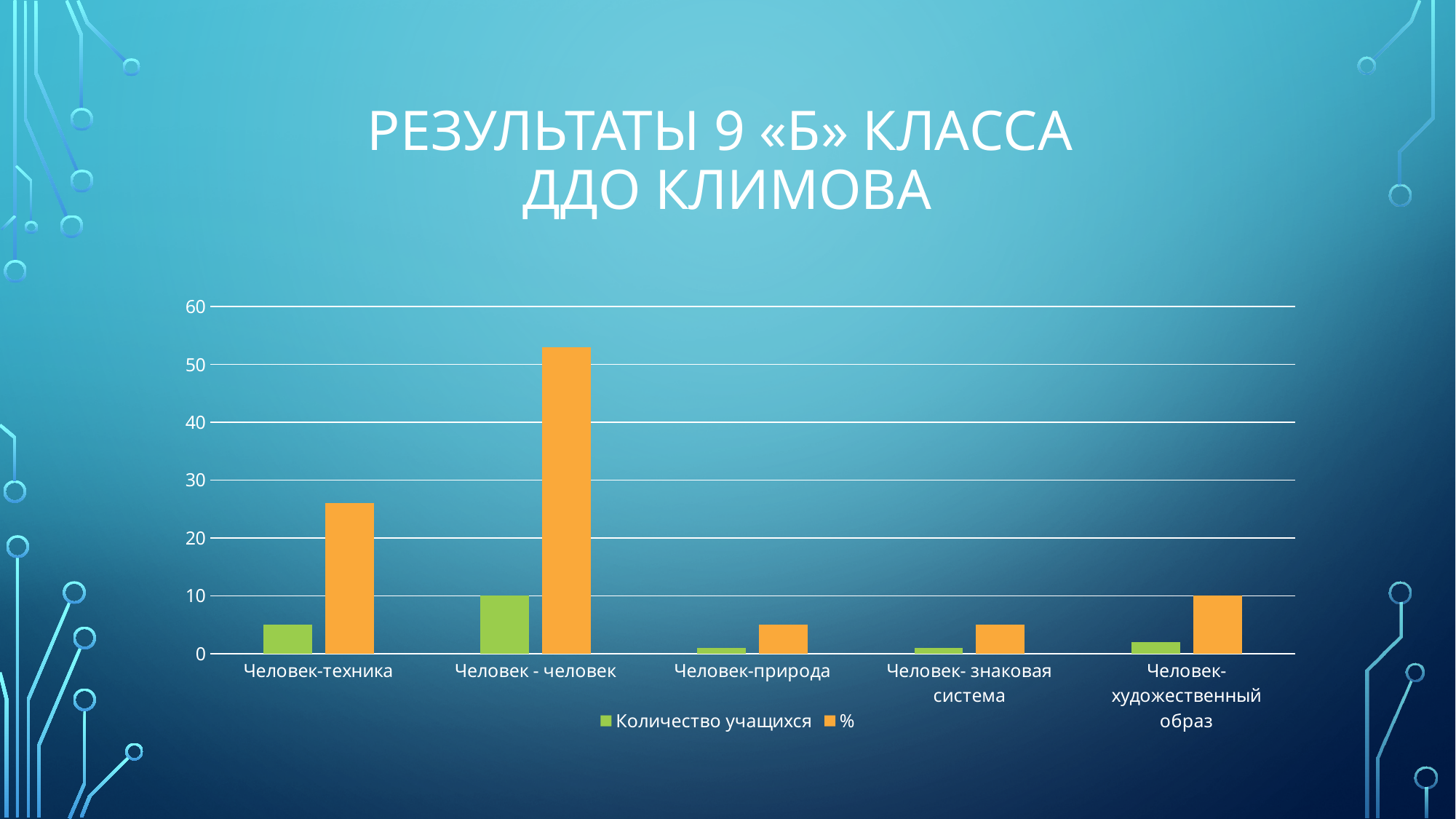
How many categories are shown on the x axis? 5 How many series does the legend list? 2 Is the % value for Человек - человек greater or less than 50? greater What is the value of Количество учащихся for Человек - человек? 10 Which category has the highest % value? Человек - человек Which is larger: the % value for Человек-техника or the % value for Человек-художественный образ? Человек-техника What is the % value for Человек-художественный образ? 10 What are the two legend entries of the chart? Количество учащихся and % What kind of chart is shown on the slide? bar chart Is the % value for Человек-природа greater or less than 10? less Is the % value for Человек-техника greater or less than 30? less Which category has the highest value for Количество учащихся? Человек - человек